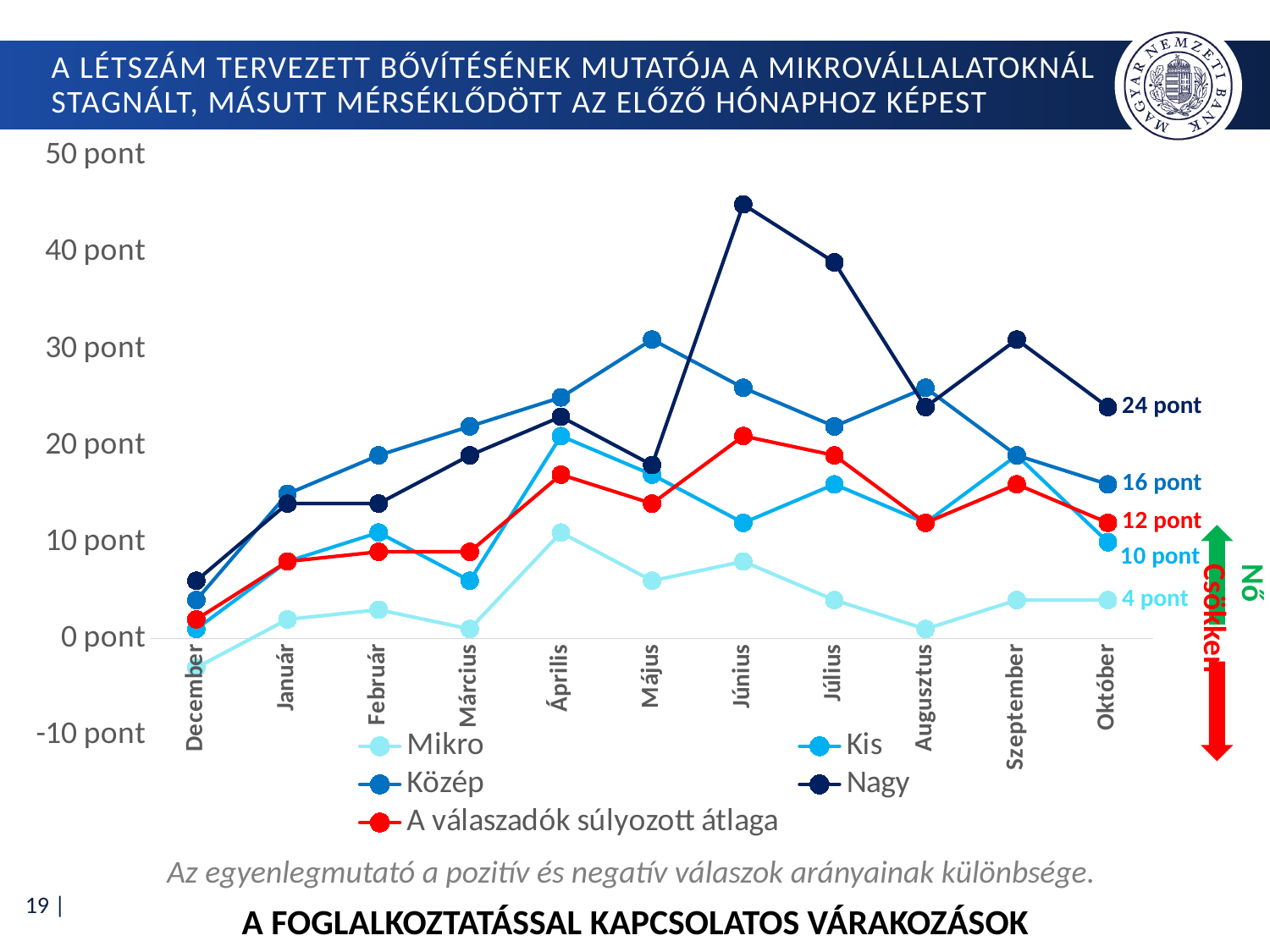
In Október, which is larger: the value for Közép or the value for Kis? Közép What is the value for Nagy in Október? 24 pont What is the value for Kis in Október? 10 pont How many series does the legend list? 5 Which series has the highest value in Október? Nagy How many months are shown along the x axis? 11 In which month does the Nagy series reach its highest value? Június What kind of chart is shown on the slide? line chart Is the value for Nagy in Június greater or less than 40 pont? greater What is the difference between the Nagy and Közép values in Október? 8 pont Is the value for Mikro in December greater or less than 0 pont? less What is the value for Mikro in Október? 4 pont